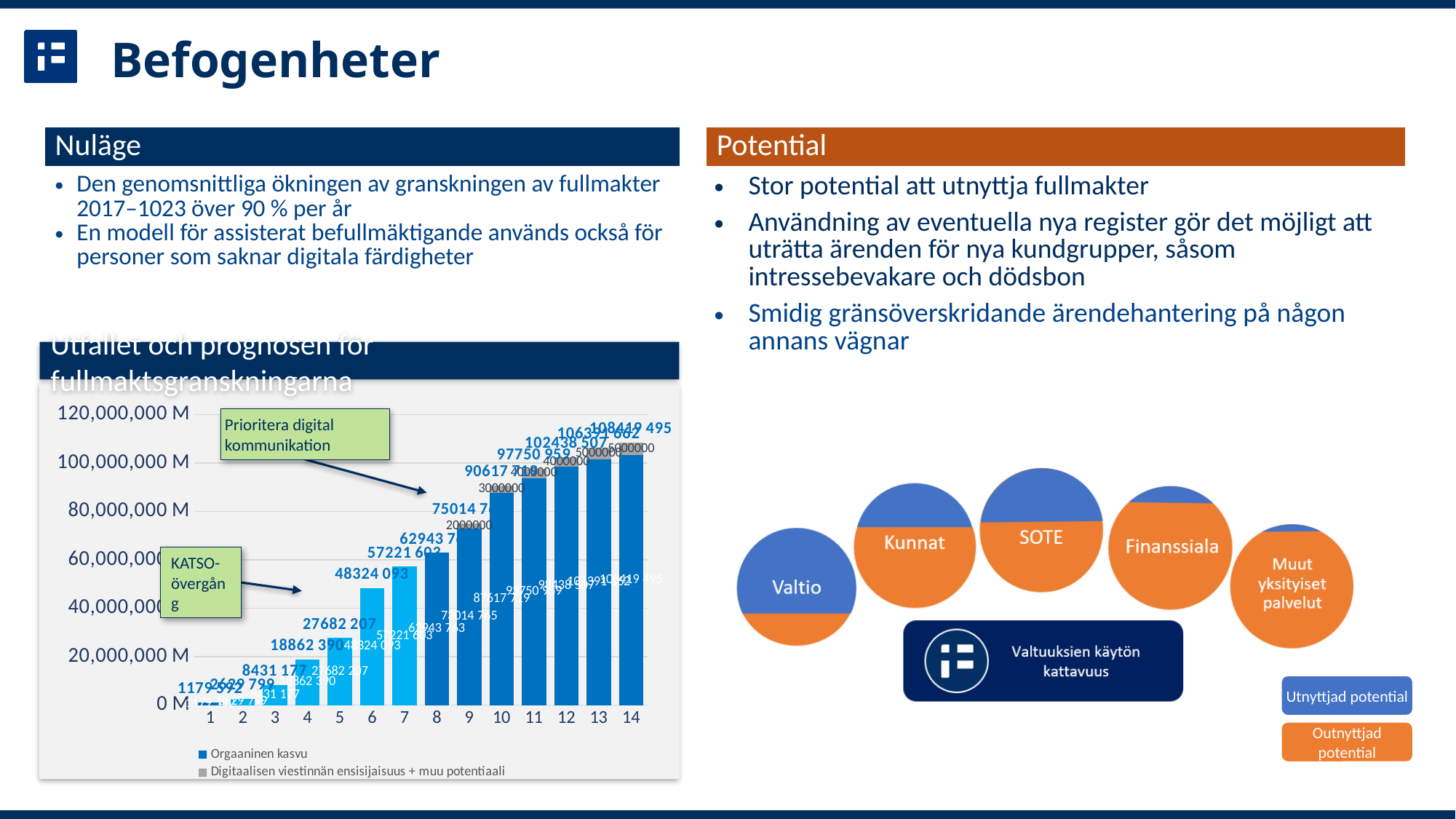
Which category has the tallest bar in the bar chart? 14 How many series does the legend of the bar chart list? 2 What are the two legend entries of the bar chart? Orgaaninen kasvu; Digitaalisen viestinnän ensisijaisuus + muu potentiaali What is the value labelled above the bar for category 6? 48324 093 Is the value for category 5 greater or less than 40,000,000? less How many categories are shown on the x axis of the bar chart? 14 What is the total value labelled above the bar for category 14? 108419 495 What kind of chart is shown under the heading 'Utfallet och prognosen för fullmaktsgranskningarna'? bar chart Which category has the shortest bar in the bar chart? 1 Is the value for category 10 greater or less than 80,000,000? greater Do the bar values rise or fall from category 1 to category 14? rise Which is larger, the bar for category 7 or the bar for category 6? category 7